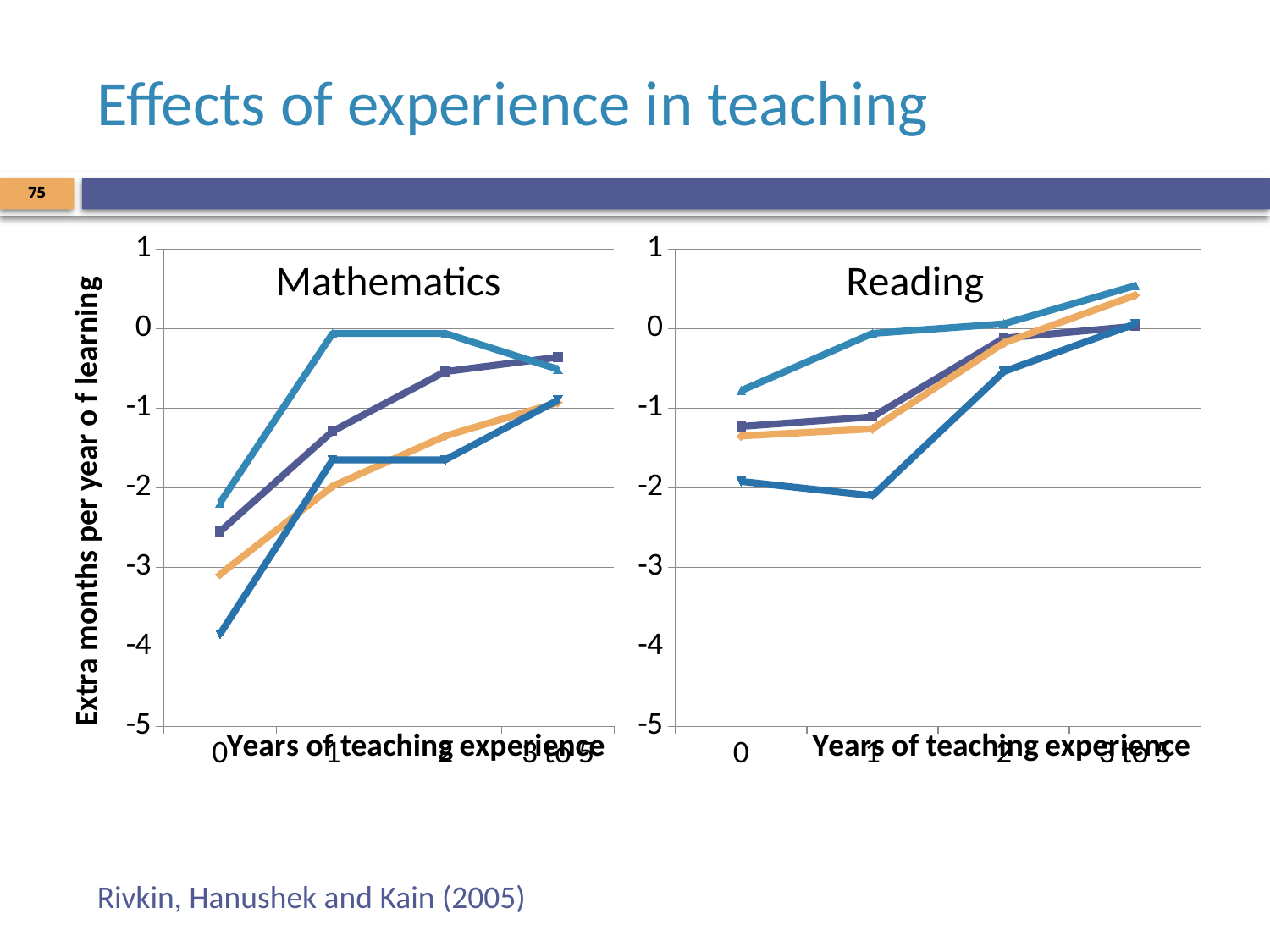
What source is cited below the charts? Rivkin, Hanushek and Kain (2005) In the Mathematics chart, is the lowest value at 0 years of experience greater or less than -3? less In the Mathematics chart, which x-axis category has the lowest values across all lines? 0 In the Reading chart, do the lines generally rise or fall as years of teaching experience increase? rise What kind of chart is the Mathematics chart? line chart How many lines are plotted in the Mathematics chart? 4 In the Mathematics chart, is the highest value at 0 years of experience greater or less than -2? less In the Mathematics chart, do the lines generally rise or fall as years of teaching experience increase? rise How many points are on the x axis of the Reading chart? 4 What is the title of the vertical axis on the Mathematics chart? Extra months per year of learning In the Reading chart, is the lowest value at 0 years of experience greater or less than -3? greater